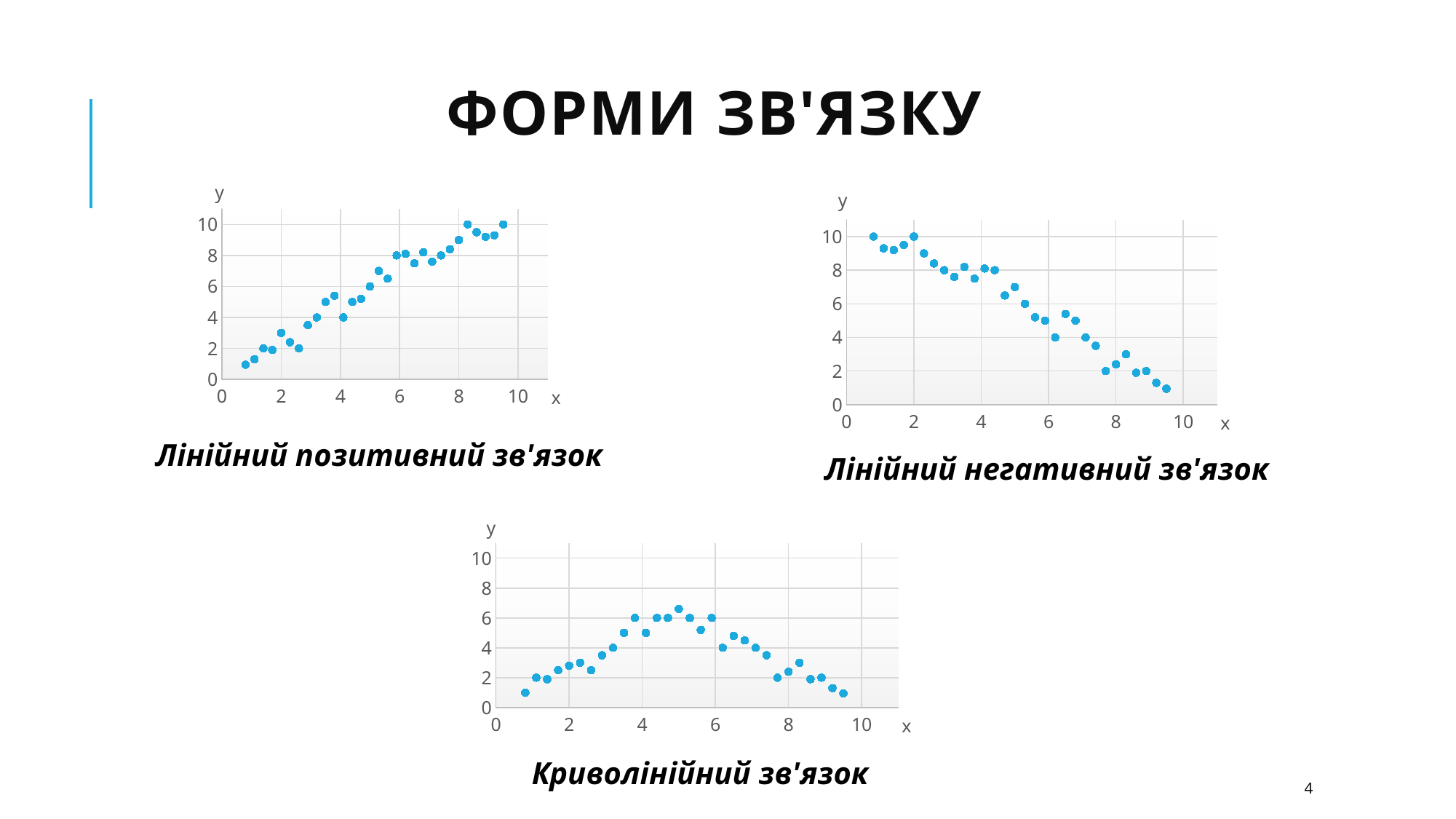
In the top-left chart "Лінійний позитивний зв'язок", do the y values rise or fall as x increases? rise In the top-right chart "Лінійний негативний зв'язок", do the y values rise or fall as x increases? fall In the top-right chart "Лінійний негативний зв'язок", is the y value of the rightmost point greater or less than 2? less In the bottom chart "Криволінійний зв'язок", how do the y values change as x increases? rise then fall How many charts are shown on the slide? 3 In the bottom chart "Криволінійний зв'язок", is the y value of the leftmost point greater or less than 2? less In the top-right chart "Лінійний негативний зв'язок", is the y value of the leftmost point greater or less than 8? greater What is the caption of the bottom chart? Криволінійний зв'язок What is the maximum value shown on the y axis of the top-left chart "Лінійний позитивний зв'язок"? 10 What kind of chart is the top-left chart titled "Лінійний позитивний зв'язок"? scatter chart